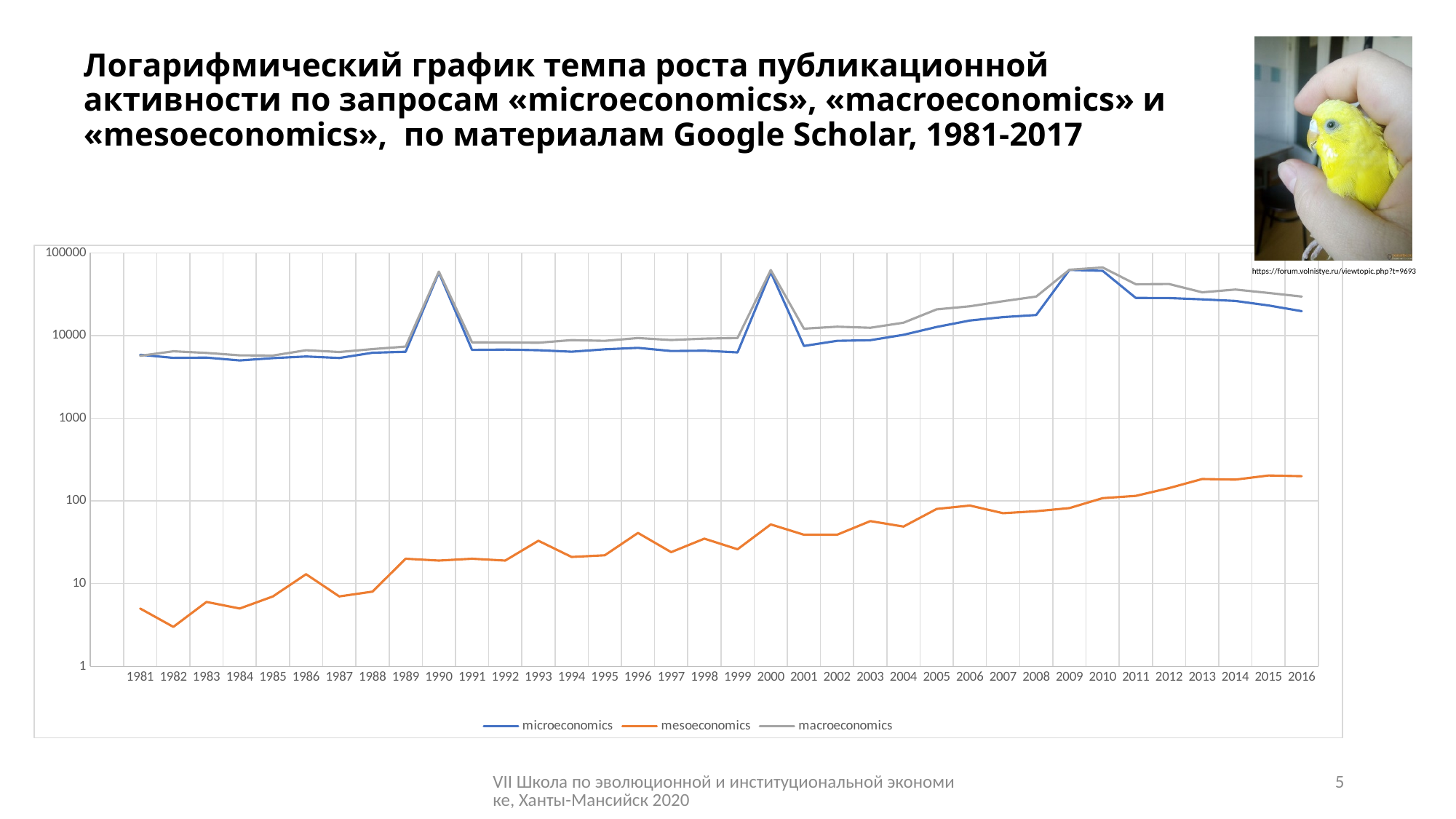
In 2016, which series has the larger value: microeconomics or macroeconomics? macroeconomics What kind of chart is shown on the slide? line chart Is the value for microeconomics in 1981 greater or less than 10000? less What colour is the mesoeconomics line in the chart? orange In 2016, which series has the larger value: macroeconomics or mesoeconomics? macroeconomics Is the value for macroeconomics in 2016 greater or less than 10000? greater Is the value for mesoeconomics in 1990 greater or less than 100? less Does the mesoeconomics series generally rise or fall from 1981 to 2016? rise How many years are plotted along the x axis of the chart? 36 How many series does the chart legend list? 3